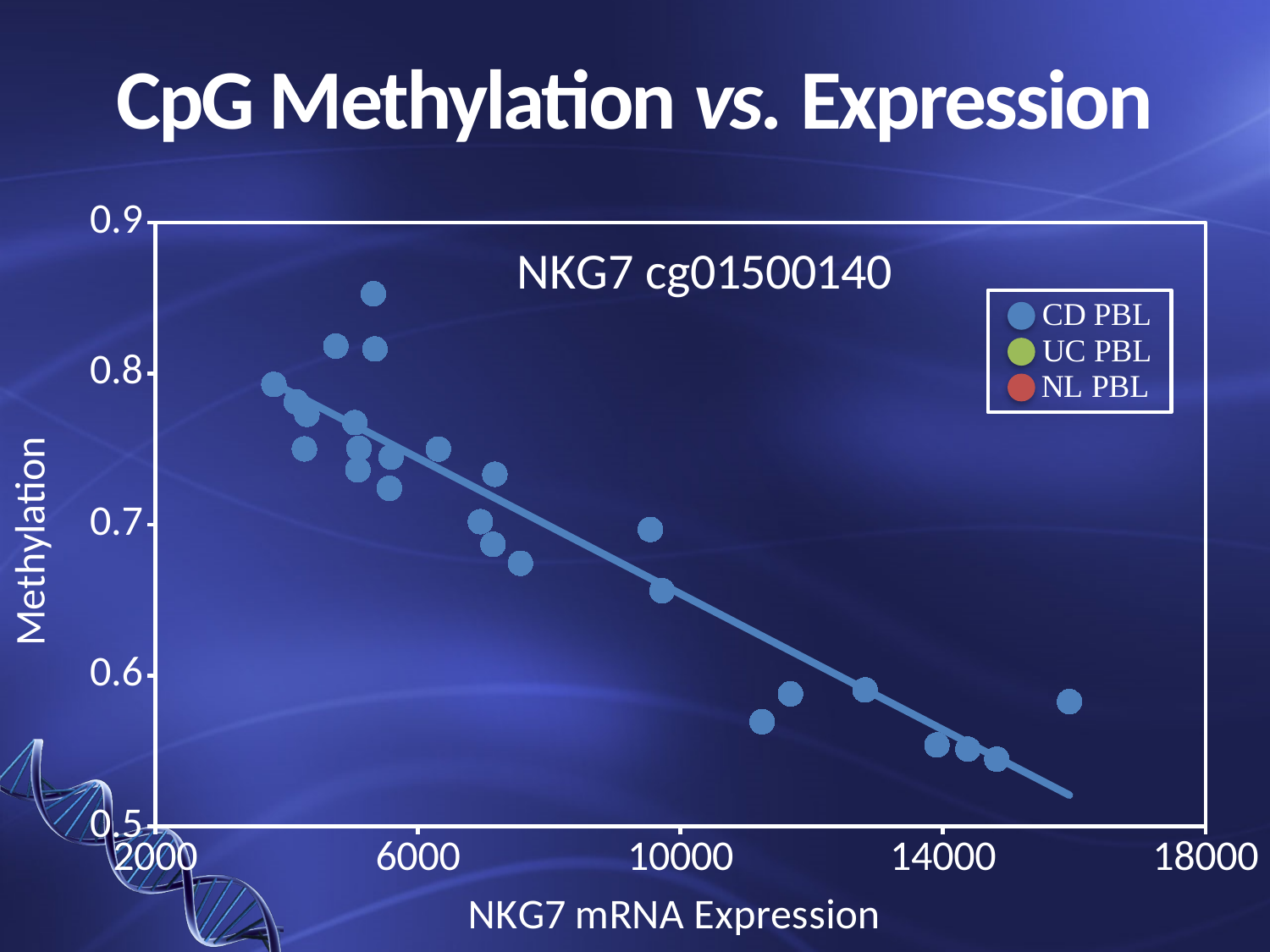
Is the NKG7 mRNA Expression of the rightmost point greater or less than 14000? greater Is the Methylation value of the lowest point on the chart greater or less than 0.6? less Is the Methylation value of the point near 10000 on the x axis greater or less than 0.6? greater How many series does the legend list? 3 What kind of chart is shown on the slide? scatter plot What is the title printed inside the chart area? NKG7 cg01500140 As NKG7 mRNA Expression increases along the x axis, does Methylation rise or fall? fall What is the label of the x axis? NKG7 mRNA Expression Which has the higher Methylation: the leftmost point or the rightmost point? the leftmost point